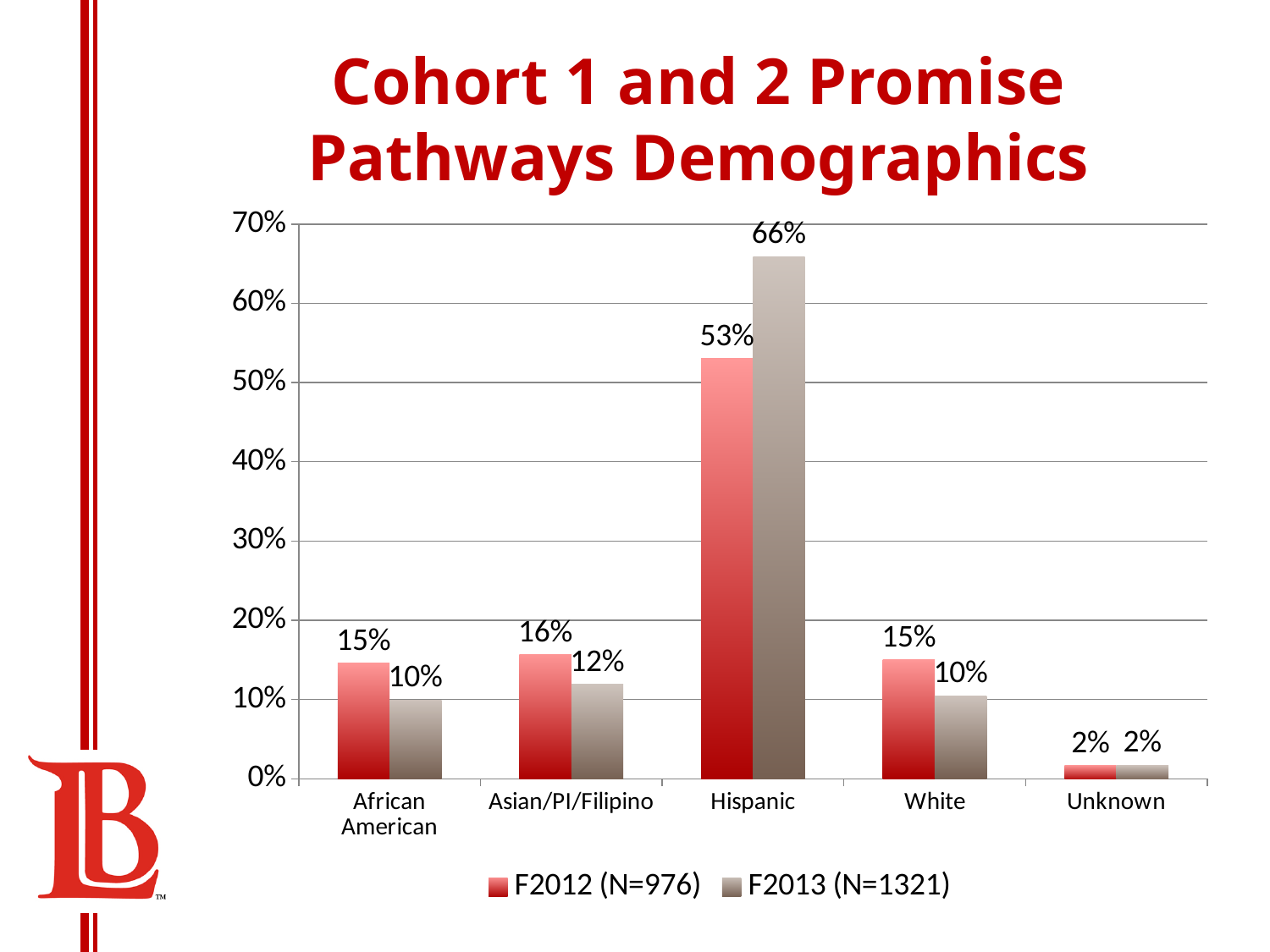
Which is larger for African American: the F2012 (N=976) value or the F2013 (N=1321) value? F2012 (N=976) How many categories are shown on the x axis? 5 What kind of chart is shown on the slide? Bar chart Which category has the lowest F2013 (N=1321) value? Unknown Which category has the highest F2012 (N=976) value? Hispanic Is the F2013 (N=1321) value for Hispanic greater or less than 60%? greater What is the title of the chart? Cohort 1 and 2 Promise Pathways Demographics What is the F2013 (N=1321) value for White? 10% How many series does the legend list? 2 What is the difference between the F2013 and F2012 values for Hispanic? 13% What is the F2012 (N=976) value for Asian/PI/Filipino? 16% What is the F2013 (N=1321) value for Hispanic? 66%